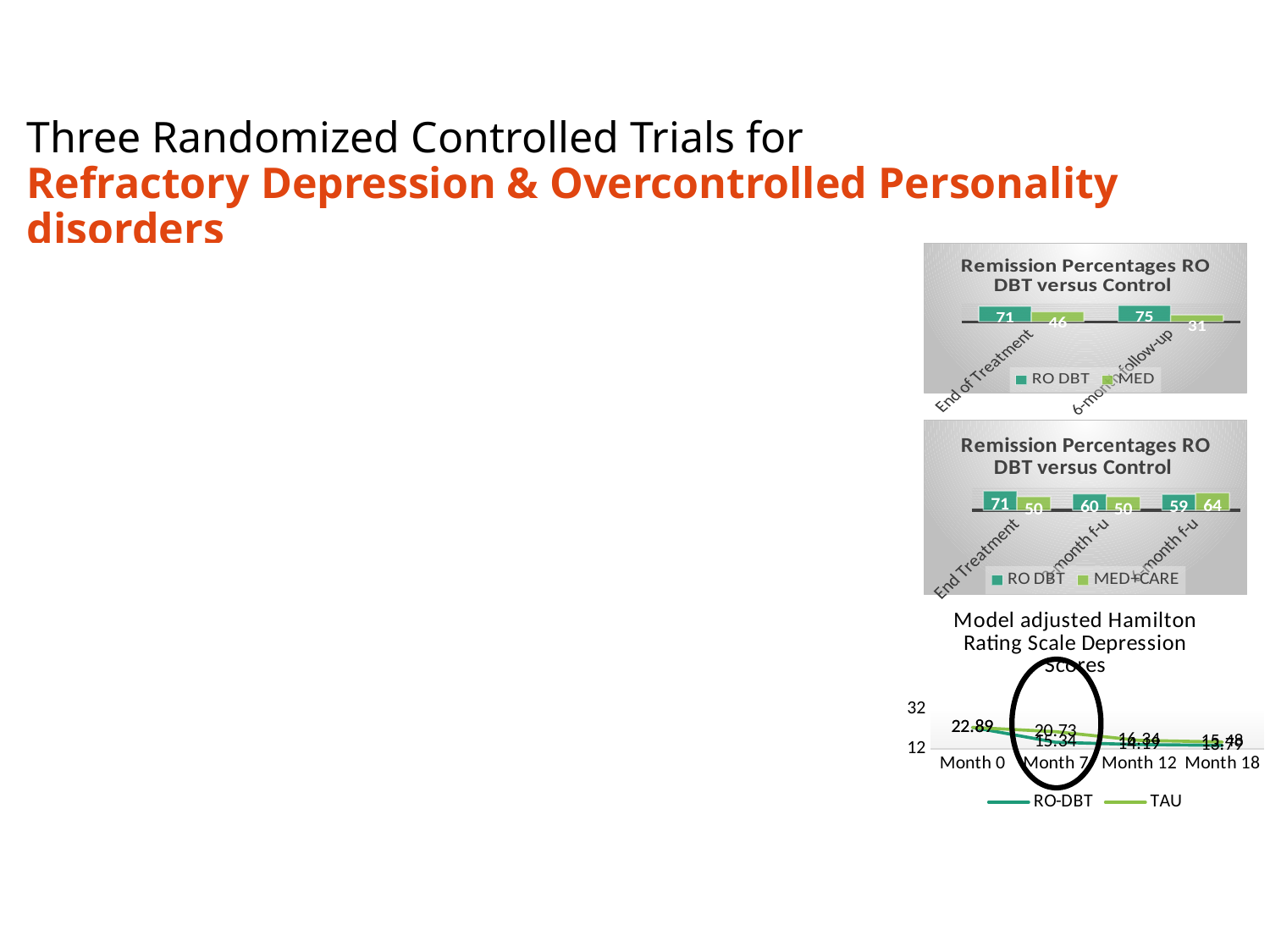
In the bottom chart (Model adjusted Hamilton Rating Scale Depression Scores), do the scores rise or fall from Month 0 to Month 18? Fall In the bottom chart (Model adjusted Hamilton Rating Scale Depression Scores), what is the RO-DBT value at Month 7? 15.34 In the top chart (Remission Percentages RO DBT versus Control, with MED), what is the value for MED at 6-month follow-up? 31 In the top chart (Remission Percentages RO DBT versus Control, with MED), what is the remission percentage for RO DBT at End of Treatment? 71 In the top chart (Remission Percentages RO DBT versus Control, with MED), which bar has the highest value? RO DBT at 6-month follow-up (75) In the middle chart (Remission Percentages RO DBT versus Control, with MED+CARE), how many categories are shown on the x axis? 3 What kind of chart is the bottom chart (Model adjusted Hamilton Rating Scale Depression Scores)? Line chart In the middle chart (Remission Percentages RO DBT versus Control, with MED+CARE), which series has the larger value at the last follow-up category, RO DBT or MED+CARE? MED+CARE In the top chart (Remission Percentages RO DBT versus Control, with MED), what is the difference between RO DBT and MED at End of Treatment? 25 In the middle chart (Remission Percentages RO DBT versus Control, with MED+CARE), what is the value for MED+CARE at End Treatment? 50 What kind of chart is the top chart on the slide? Bar chart In the middle chart (Remission Percentages RO DBT versus Control, with MED+CARE), what is the value for RO DBT at End Treatment? 71